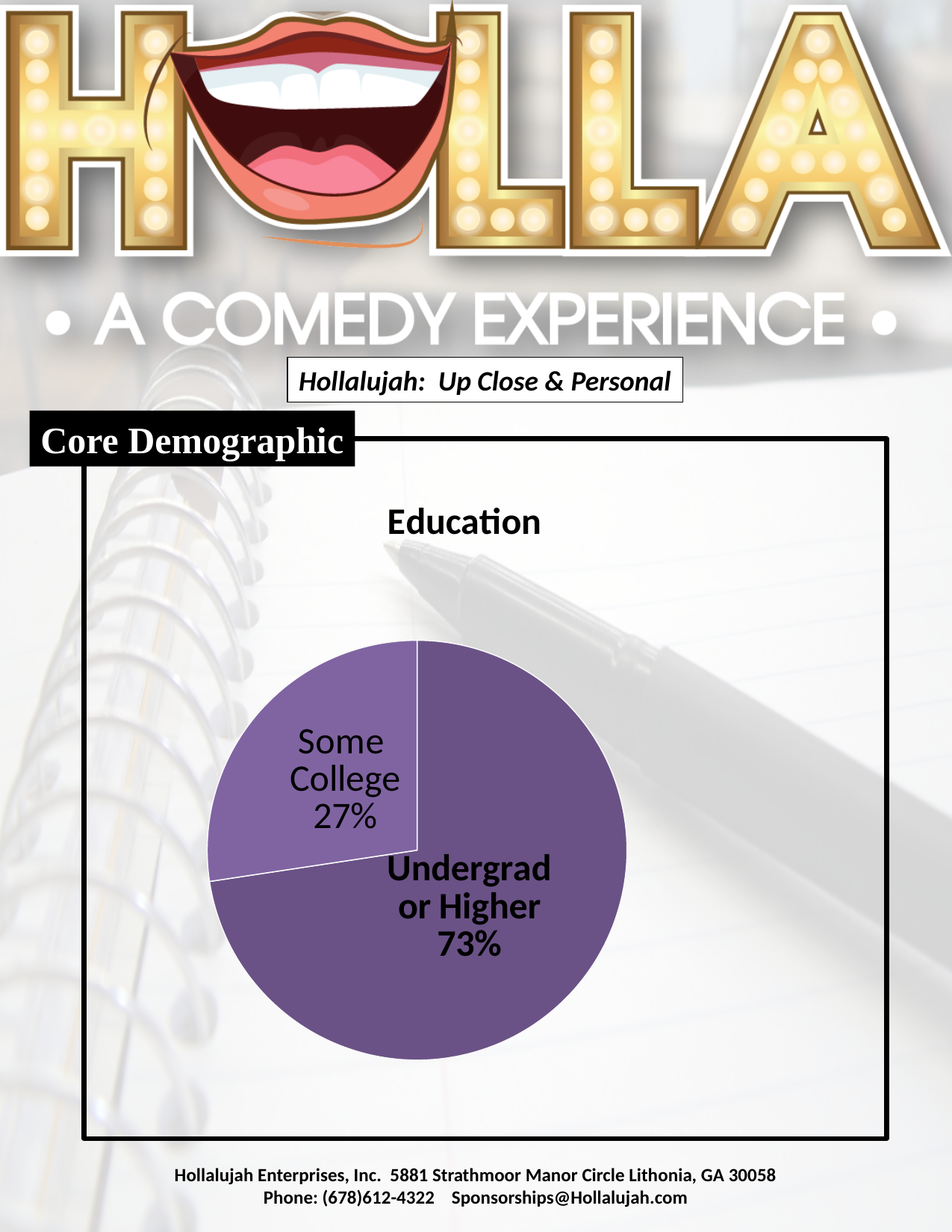
What is the combined share of the two slices in the pie chart? 100% What kind of chart is shown on the slide? pie chart How many slices does the pie chart have? 2 Which slice of the pie is the largest? Undergrad or Higher What is the difference in percentage points between Undergrad or Higher and Some College? 46 What is the heading of the section containing the chart? Core Demographic What share of the pie is Some College? 27% What is the title of the chart? Education Which slice of the pie is the smallest? Some College Which is larger, the Some College slice or the Undergrad or Higher slice? Undergrad or Higher What share of the pie is Undergrad or Higher? 73%